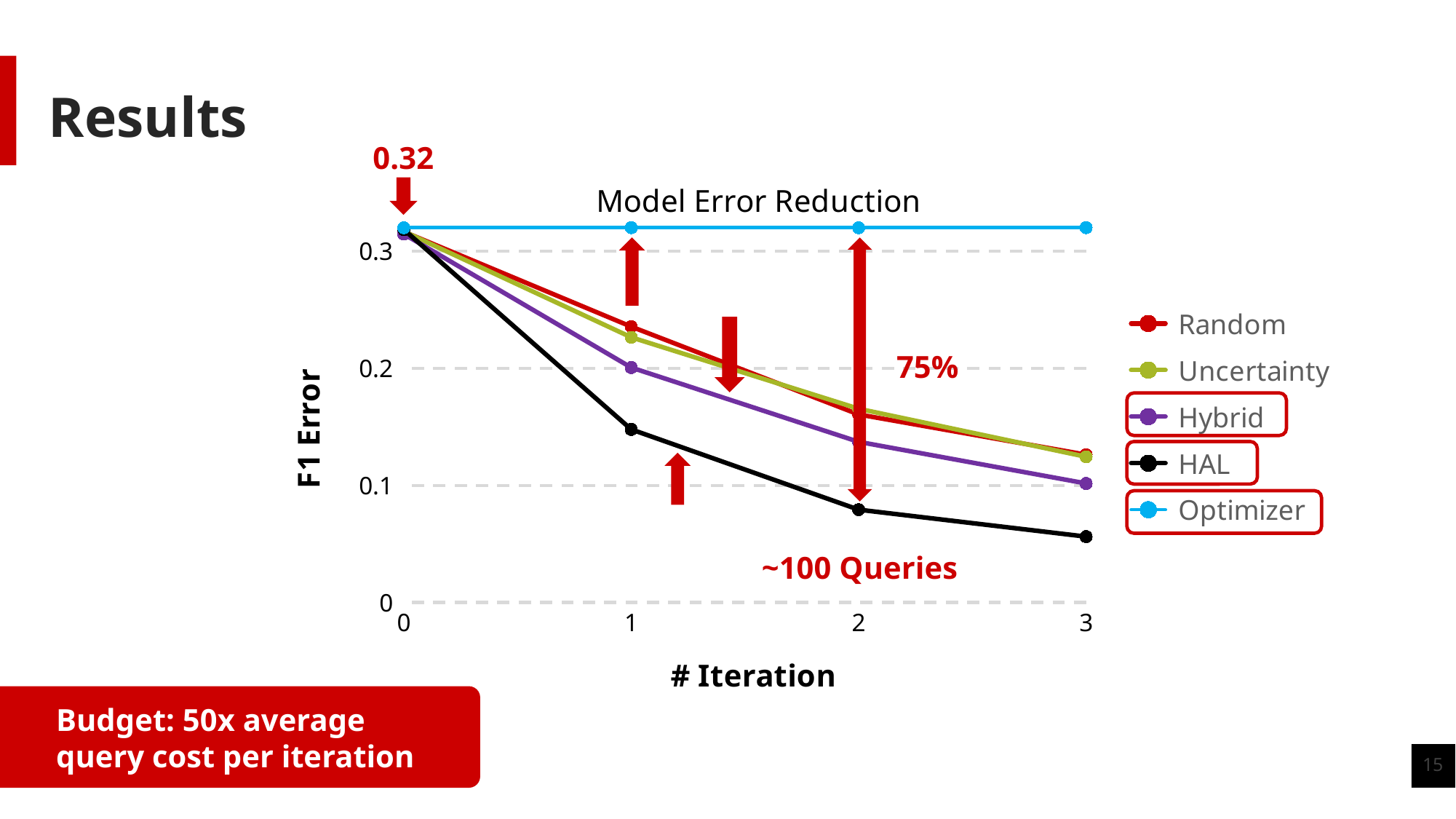
What is the label of the y axis? F1 Error Is the F1 Error for HAL at iteration 1 greater or less than 0.2? less What is the title of the chart? Model Error Reduction How many iteration points are plotted for each series? 4 What is the F1 Error value of the Optimizer series at iteration 0, as annotated on the slide? 0.32 At iteration 2, which series has the larger F1 Error, Hybrid or HAL? Hybrid What kind of chart is shown on the slide? line chart How many series does the legend list? 5 Which series has the highest F1 Error at iteration 3? Optimizer Is the F1 Error for Random at iteration 1 greater or less than 0.2? greater Does the F1 Error for HAL rise or fall as the iteration number increases? fall Which series has the lowest F1 Error at iteration 3? HAL